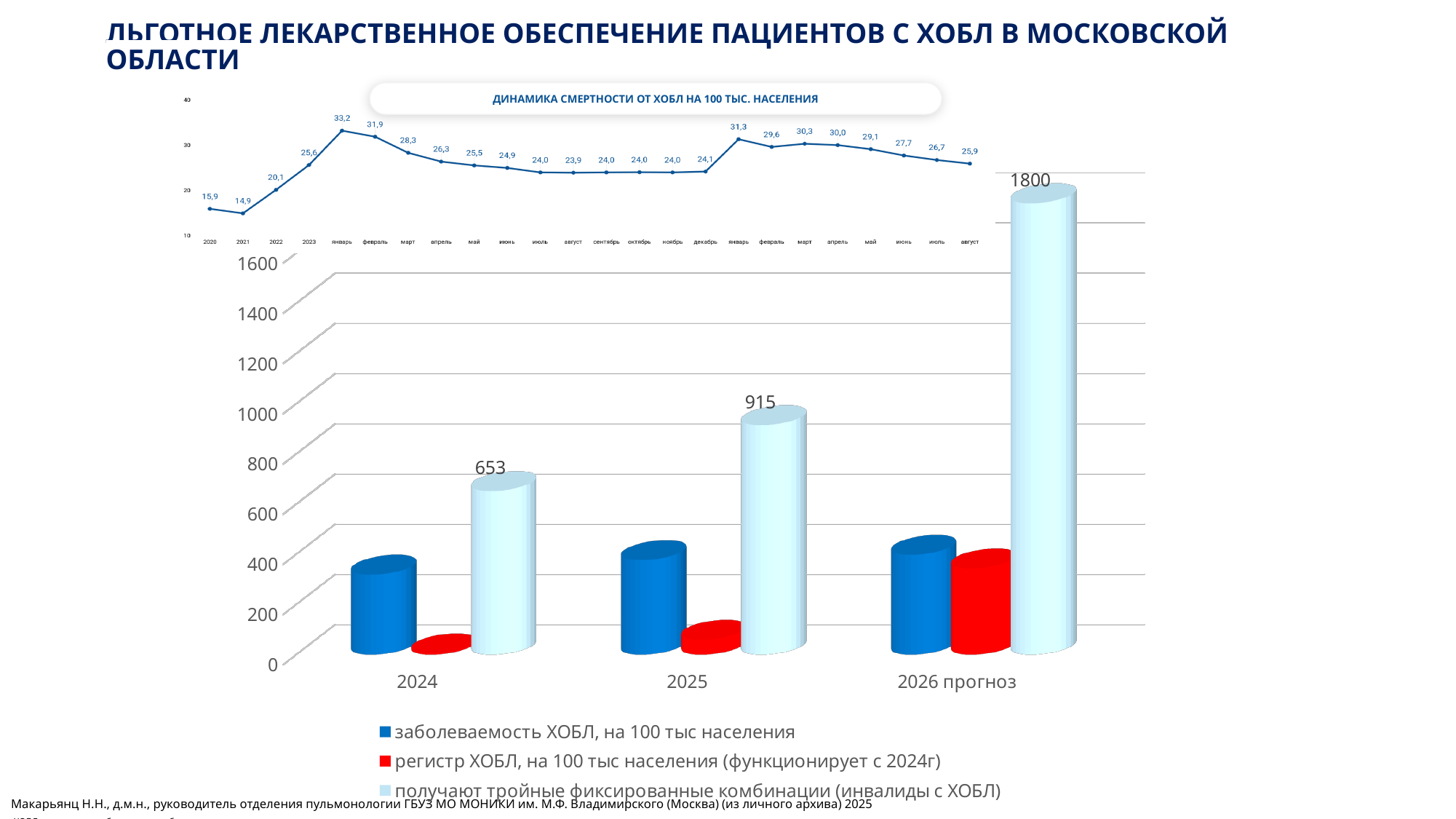
In the bar chart, what is the value for 'получают тройные фиксированные комбинации (инвалиды с ХОБЛ)' in 2025? 915 In the bar chart, is the value for 'регистр ХОБЛ, на 100 тыс населения' in 2024 greater or less than 200? less In the bar chart, do the values for 'получают тройные фиксированные комбинации (инвалиды с ХОБЛ)' rise or fall from 2024 to 2026 прогноз? rise In the line chart 'ДИНАМИКА СМЕРТНОСТИ ОТ ХОБЛ НА 100 ТЫС. НАСЕЛЕНИЯ', what is the highest value plotted? 33,2 In the bar chart, how many series does the legend list? 3 In the line chart 'ДИНАМИКА СМЕРТНОСТИ ОТ ХОБЛ НА 100 ТЫС. НАСЕЛЕНИЯ', what is the value for 2021? 14,9 In the bar chart, how many categories are shown on the x axis? 3 In the bar chart, what is the value for 'получают тройные фиксированные комбинации (инвалиды с ХОБЛ)' in '2026 прогноз'? 1800 In the bar chart, what is the value for 'получают тройные фиксированные комбинации (инвалиды с ХОБЛ)' in 2024? 653 In the bar chart, what is the difference between the 2025 and 2024 values for 'получают тройные фиксированные комбинации (инвалиды с ХОБЛ)'? 262 What kind of chart is the top chart on the slide? line chart In the bar chart, is the value for 'заболеваемость ХОБЛ, на 100 тыс населения' in 2024 greater or less than 600? less